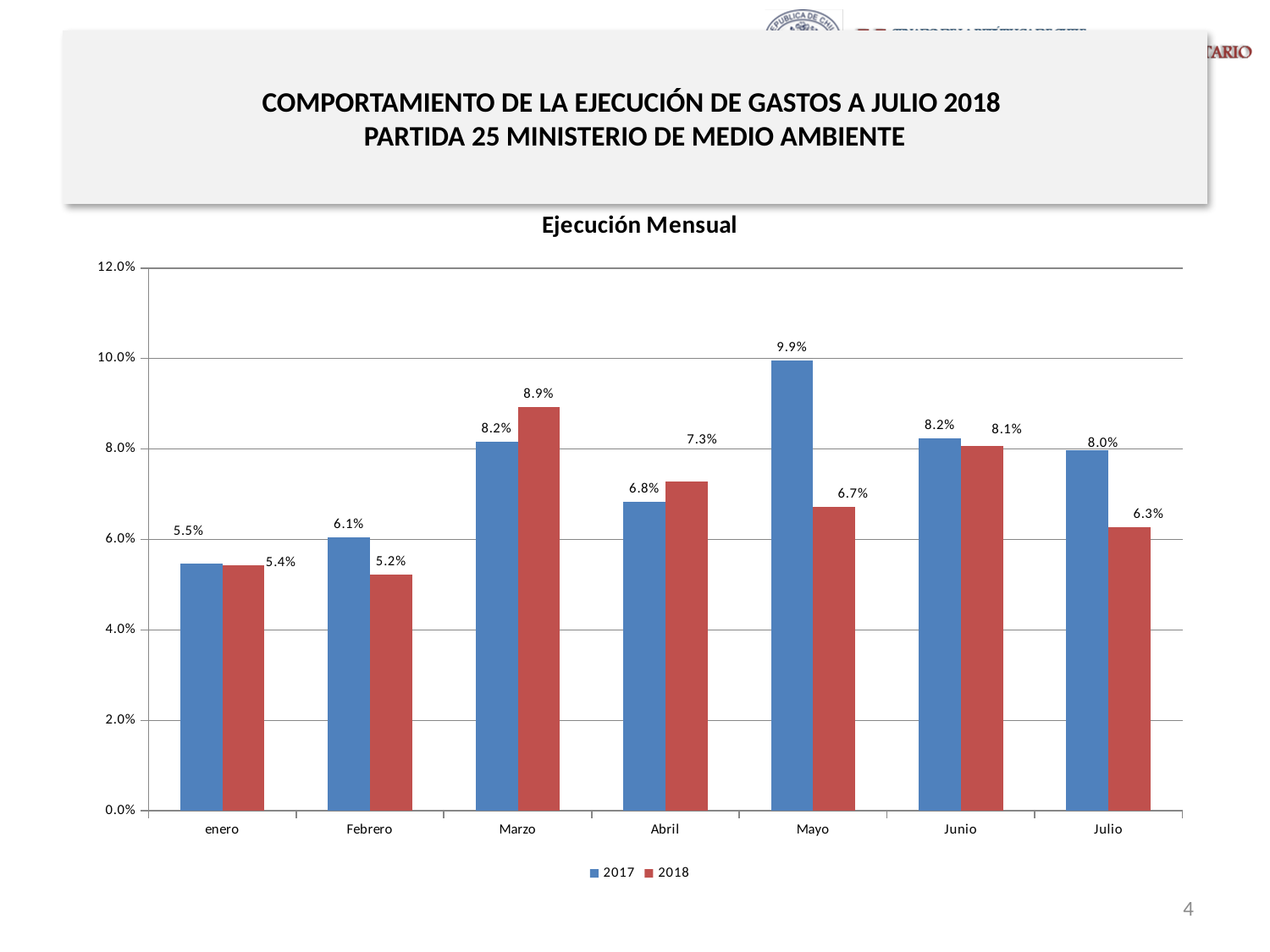
What is the title of the chart? Ejecución Mensual What is the value for 2018 in Marzo? 8.9% Which month has the lowest value for the 2018 series? Febrero What kind of chart is shown on the slide? bar chart Which is larger in Marzo, the 2017 value or the 2018 value? 2018 What is the value for 2018 in Julio? 6.3% Which month has the highest value for the 2017 series? Mayo What is the difference between the 2017 and 2018 values in Mayo? 3.2% How many series does the legend list? 2 What is the value for 2017 in Mayo? 9.9% How many months are shown on the x axis? 7 Is the value for 2018 in Abril greater or less than 8.0%? less